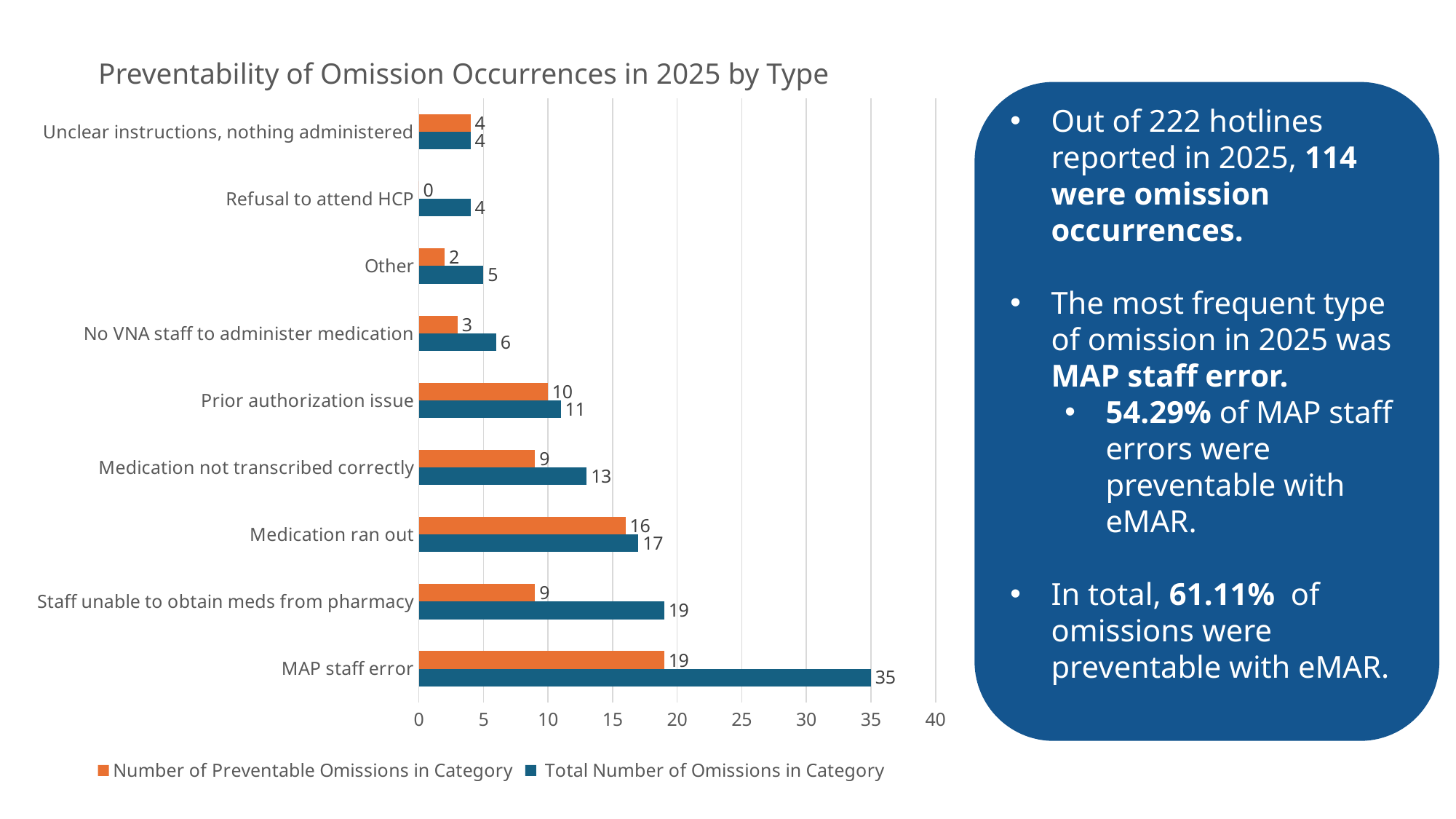
What is the Number of Preventable Omissions in Category for Medication ran out? 16 What is the difference between the Total Number of Omissions and the Number of Preventable Omissions for Staff unable to obtain meds from pharmacy? 10 Which is larger: the Total Number of Omissions for Prior authorization issue or for Medication not transcribed correctly? Medication not transcribed correctly Which category has the highest Total Number of Omissions in Category? MAP staff error Which category has the lowest Number of Preventable Omissions in Category? Refusal to attend HCP What kind of chart is shown on the slide? Bar chart What is the Total Number of Omissions in Category for MAP staff error? 35 What is the title of the chart? Preventability of Omission Occurrences in 2025 by Type How many categories are shown on the chart? 9 How many series does the legend list? 2 Is the Total Number of Omissions in Category for MAP staff error greater or less than 30? greater What is the Number of Preventable Omissions in Category for Refusal to attend HCP? 0